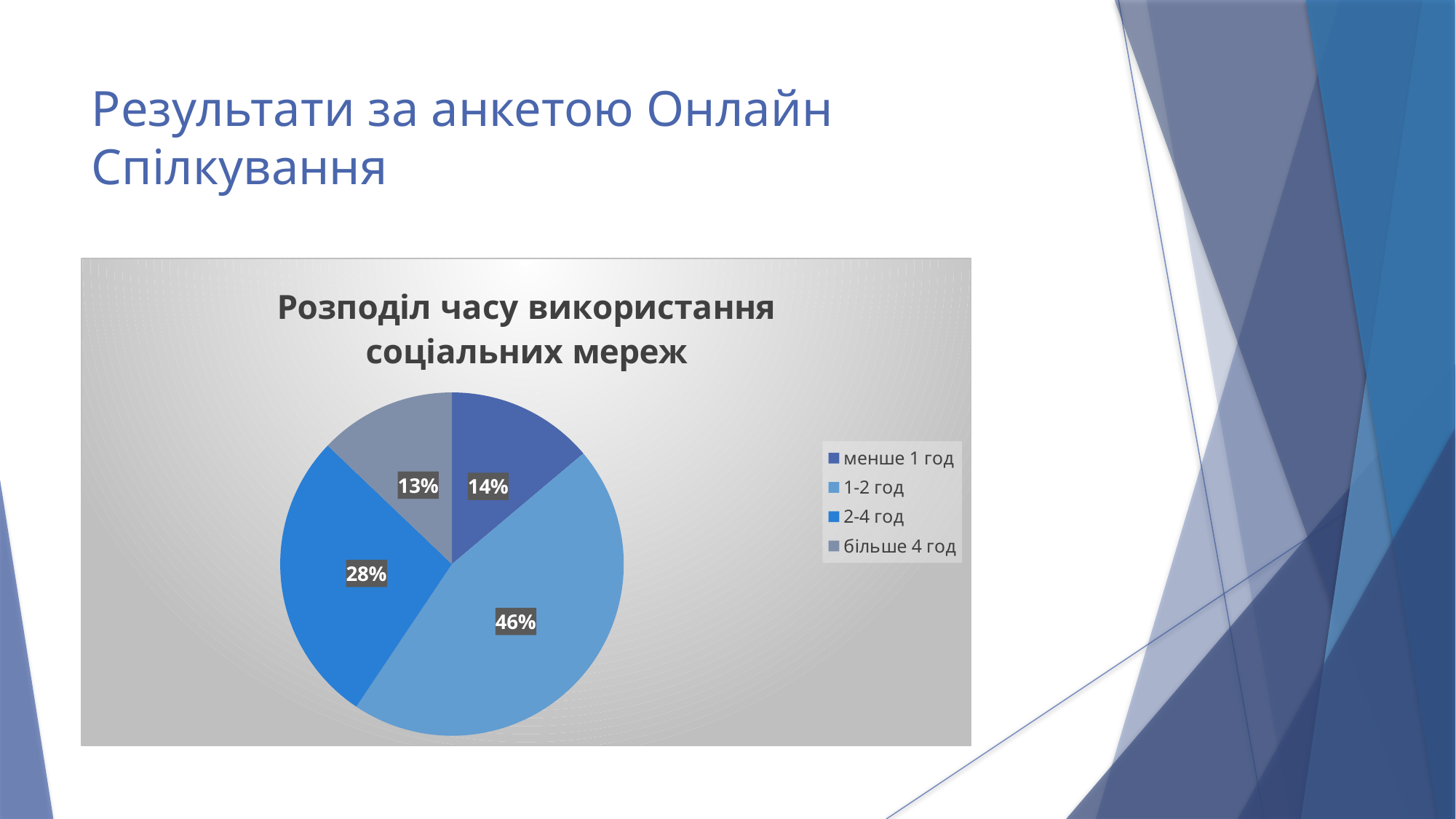
Which category has the largest slice of the pie? 1-2 год What is the combined share of "менше 1 год" and "більше 4 год"? 27% What share of the pie is labelled for "менше 1 год"? 14% What kind of chart is shown on the slide? pie chart What is the title of the chart? Розподіл часу використання соціальних мереж What is the difference between the shares for "1-2 год" and "2-4 год"? 18% Which category has the smallest slice of the pie? більше 4 год What share of the pie is labelled for "2-4 год"? 28% What share of the pie is labelled for "1-2 год"? 46% How many categories does the legend list? 4 Which is larger, the share for "2-4 год" or the share for "менше 1 год"? 2-4 год What share of the pie is labelled for "більше 4 год"? 13%